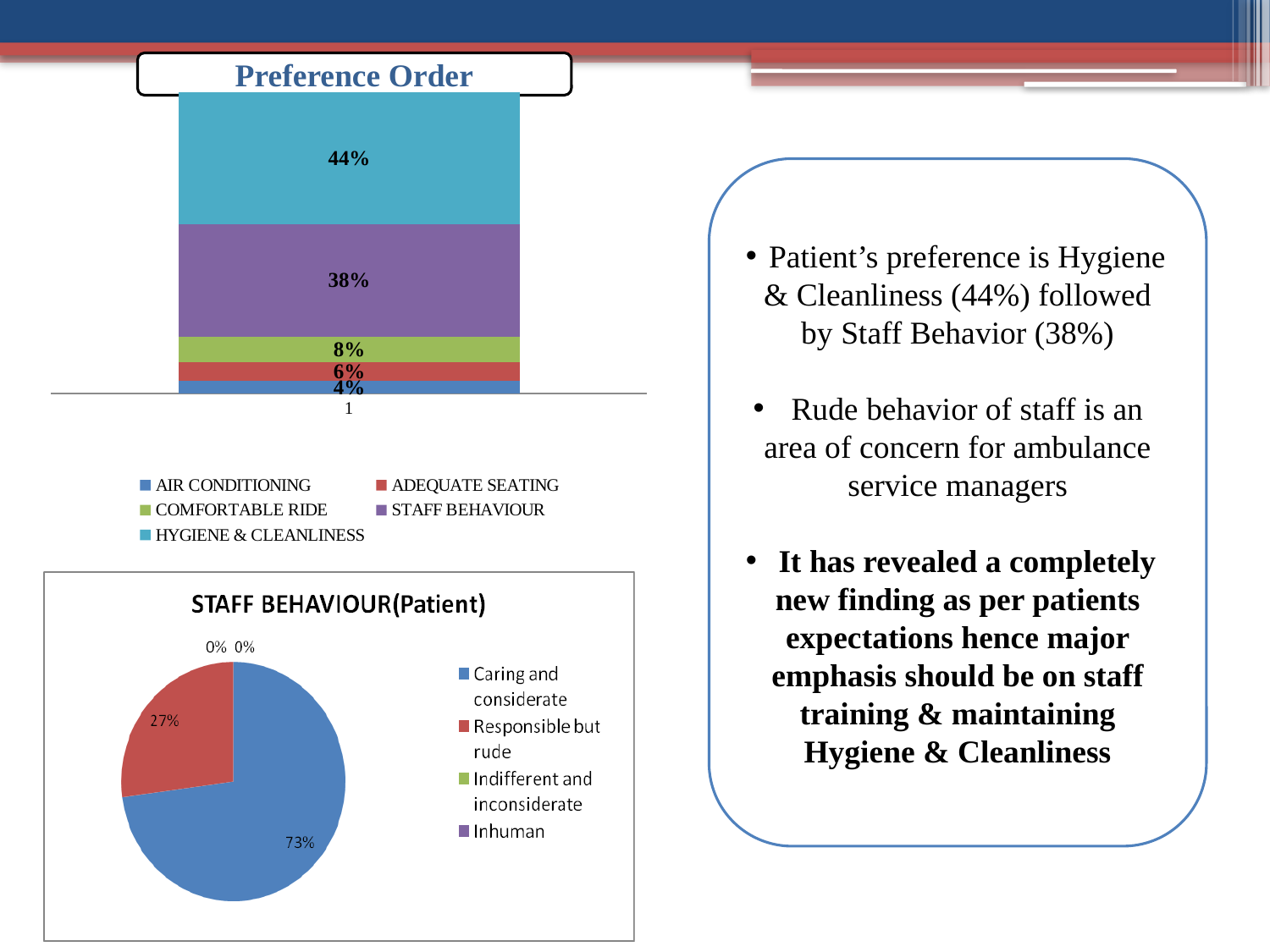
In the STAFF BEHAVIOUR(Patient) chart, what share of the pie is Caring and considerate? 73% In the Preference Order chart, which series has the highest value? HYGIENE & CLEANLINESS In the Preference Order chart, what is the value for STAFF BEHAVIOUR? 38% In the Preference Order chart, what is the difference between HYGIENE & CLEANLINESS and STAFF BEHAVIOUR? 6% What kind of chart is the Preference Order chart? Stacked bar chart In the Preference Order chart, which is larger, COMFORTABLE RIDE or ADEQUATE SEATING? COMFORTABLE RIDE In the Preference Order chart, what is the value for HYGIENE & CLEANLINESS? 44% In the STAFF BEHAVIOUR(Patient) chart, what is the value for Responsible but rude? 27% How many series does the legend of the Preference Order chart list? 5 What kind of chart is the STAFF BEHAVIOUR(Patient) chart? Pie chart In the Preference Order chart, what is the value for AIR CONDITIONING? 4% In the Preference Order chart, which series has the lowest value? AIR CONDITIONING